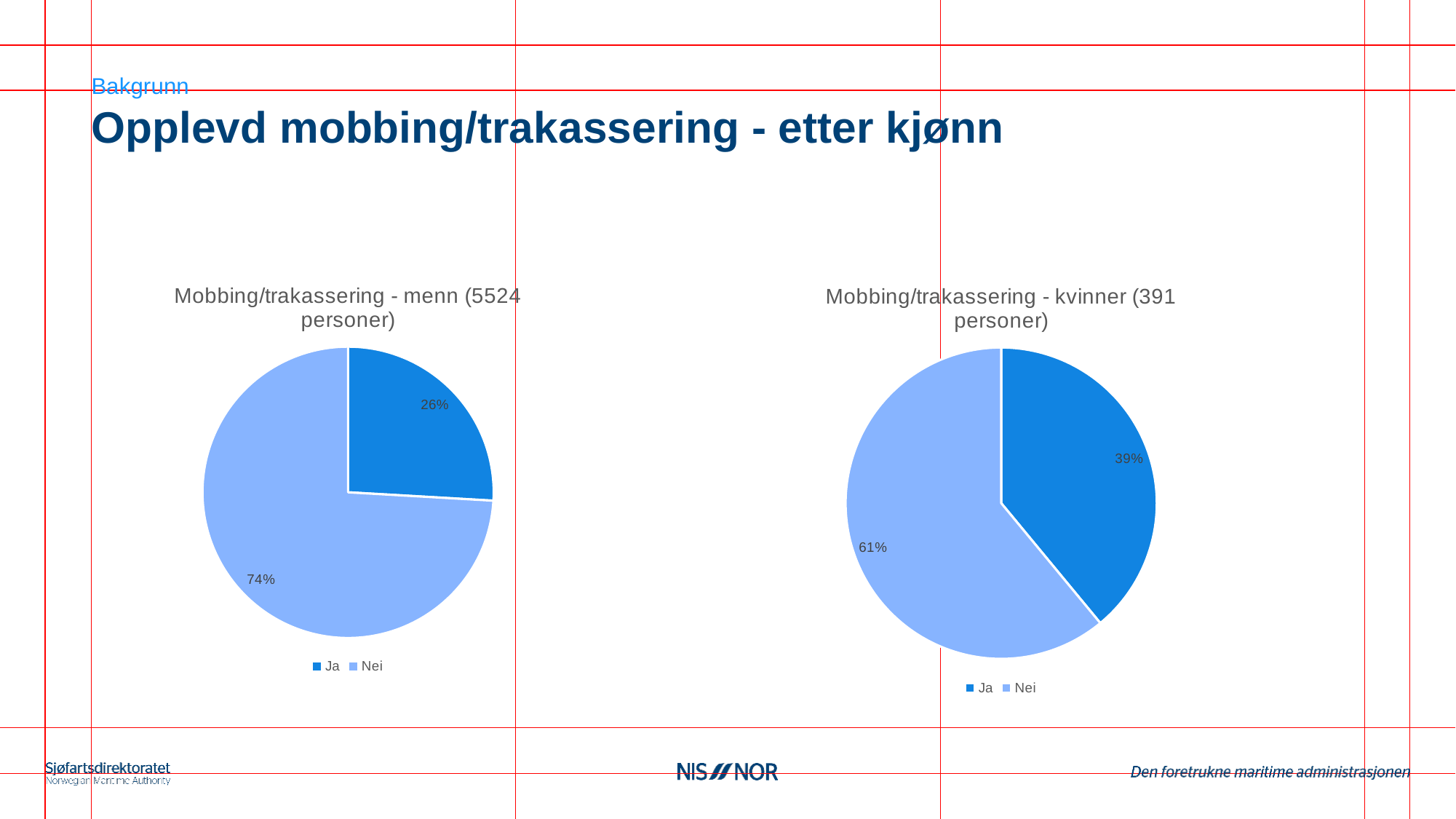
In the left chart (Mobbing/trakassering - menn), what share of the pie is labelled Ja? 26% What is the difference between the Ja share in the right chart (kvinner) and the Ja share in the left chart (menn)? 13% What type of chart is used on this slide? Pie chart In the right chart (Mobbing/trakassering - kvinner), which slice is the smallest? Ja How many persons does the title of the left chart say the menn data is based on? 5524 personer In the left chart (Mobbing/trakassering - menn), what share of the pie is labelled Nei? 74% In the right chart (Mobbing/trakassering - kvinner), what share of the pie is labelled Ja? 39% In the right chart (Mobbing/trakassering - kvinner), what share of the pie is labelled Nei? 61% How many slices does the left chart (Mobbing/trakassering - menn) have? 2 How many entries does the legend of the right chart (Mobbing/trakassering - kvinner) list? 2 In the left chart (Mobbing/trakassering - menn), which slice is the largest? Nei Which chart has the larger Ja share, the left chart (menn) or the right chart (kvinner)? The right chart (kvinner)